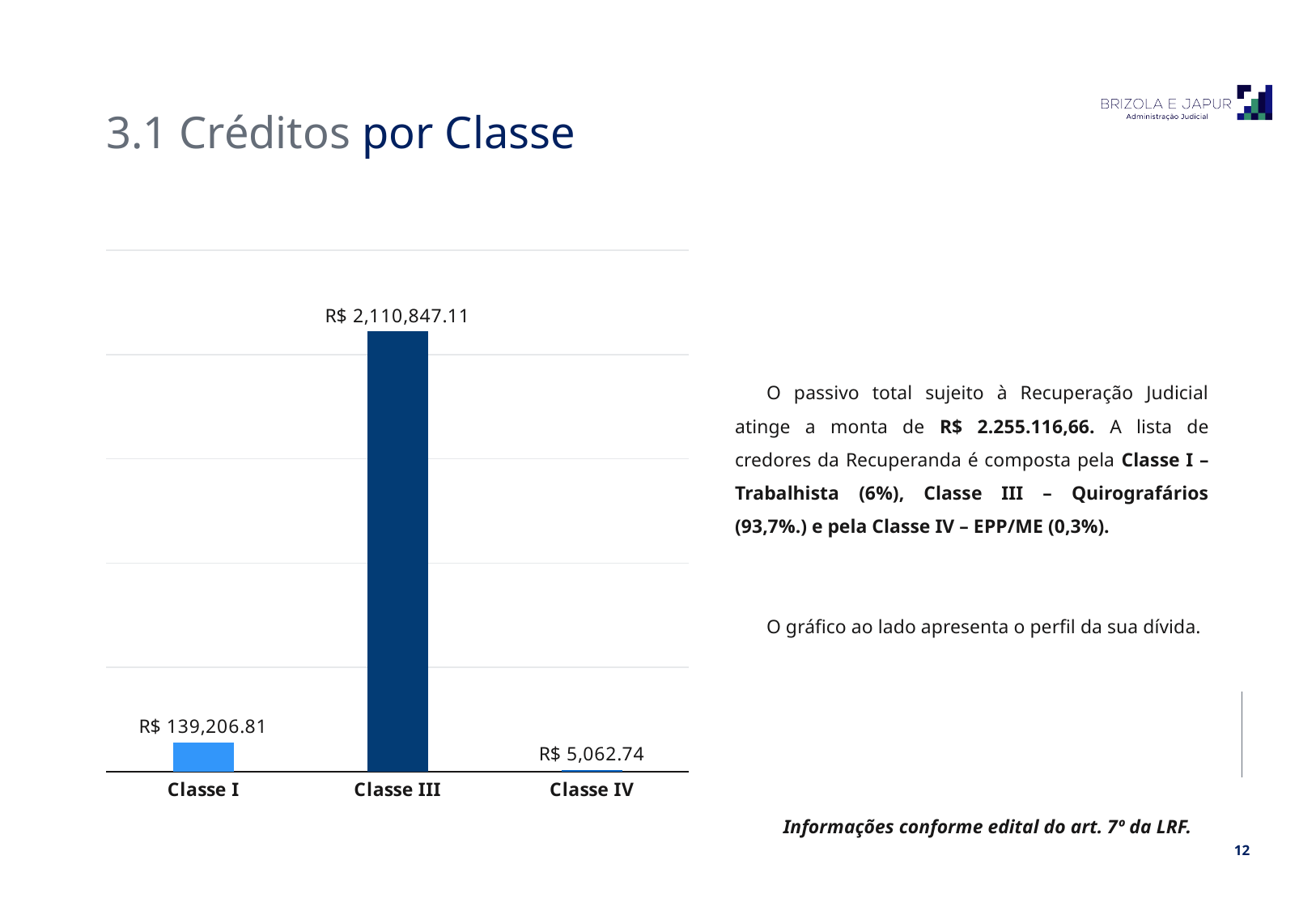
What is the sum of the values of all three bars in the chart? R$ 2,255,116.66 Which is larger, the value for Classe I or the value for Classe IV? Classe I What colour is the bar for Classe III? Dark blue What kind of chart is shown on the slide? Bar chart Which class has the lowest value? Classe IV Which class has the highest value? Classe III What is the value for Classe III? R$ 2,110,847.11 How many classes are shown in the chart? 3 What is the value for Classe IV? R$ 5,062.74 What is the value for Classe I? R$ 139,206.81 What is the difference between the values for Classe I and Classe IV? R$ 134,144.07 What is the difference between the values for Classe III and Classe I? R$ 1,971,640.30